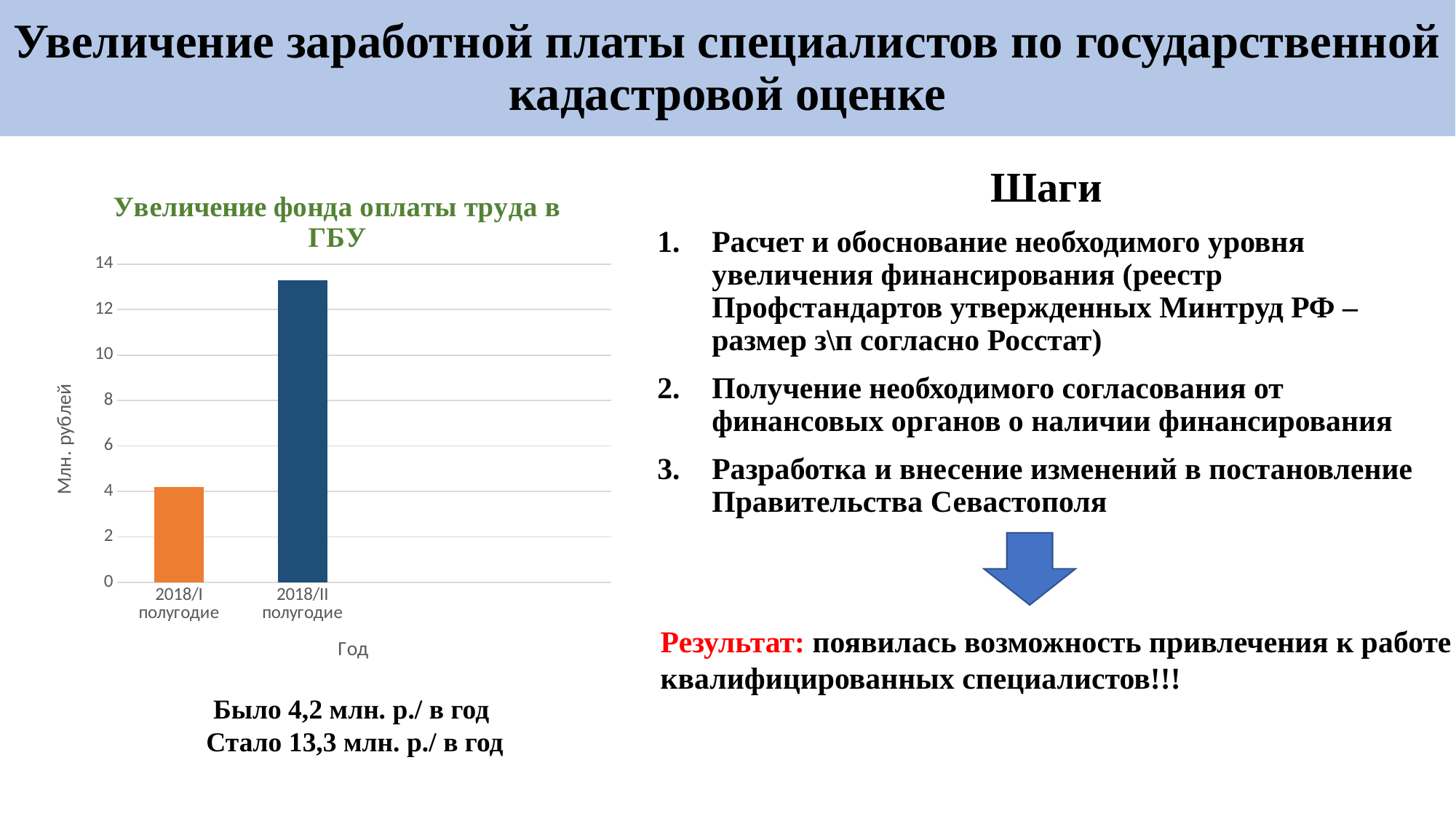
Using the values printed under the chart, by how much did the wage fund increase from 2018/I полугодие to 2018/II полугодие? 9,1 млн. р./ в год Is the value for 2018/I полугодие greater or less than 6? less Which category has the lowest bar in the chart? 2018/I полугодие Is the value for 2018/II полугодие greater or less than 12? greater Which is larger, the bar for 2018/I полугодие or the bar for 2018/II полугодие? 2018/II полугодие What kind of chart is shown under the title "Увеличение фонда оплаты труда в ГБУ"? bar chart What is the label of the vertical axis of the chart? Млн. рублей Which category has the highest bar in the chart? 2018/II полугодие Do the values rise or fall from 2018/I полугодие to 2018/II полугодие? rise According to the text under the chart, what was the wage fund value for 2018/I полугодие ("Было")? 4,2 млн. р./ в год According to the text under the chart, what is the wage fund value for 2018/II полугодие ("Стало")? 13,3 млн. р./ в год How many categories are plotted on the x axis of the chart? 2